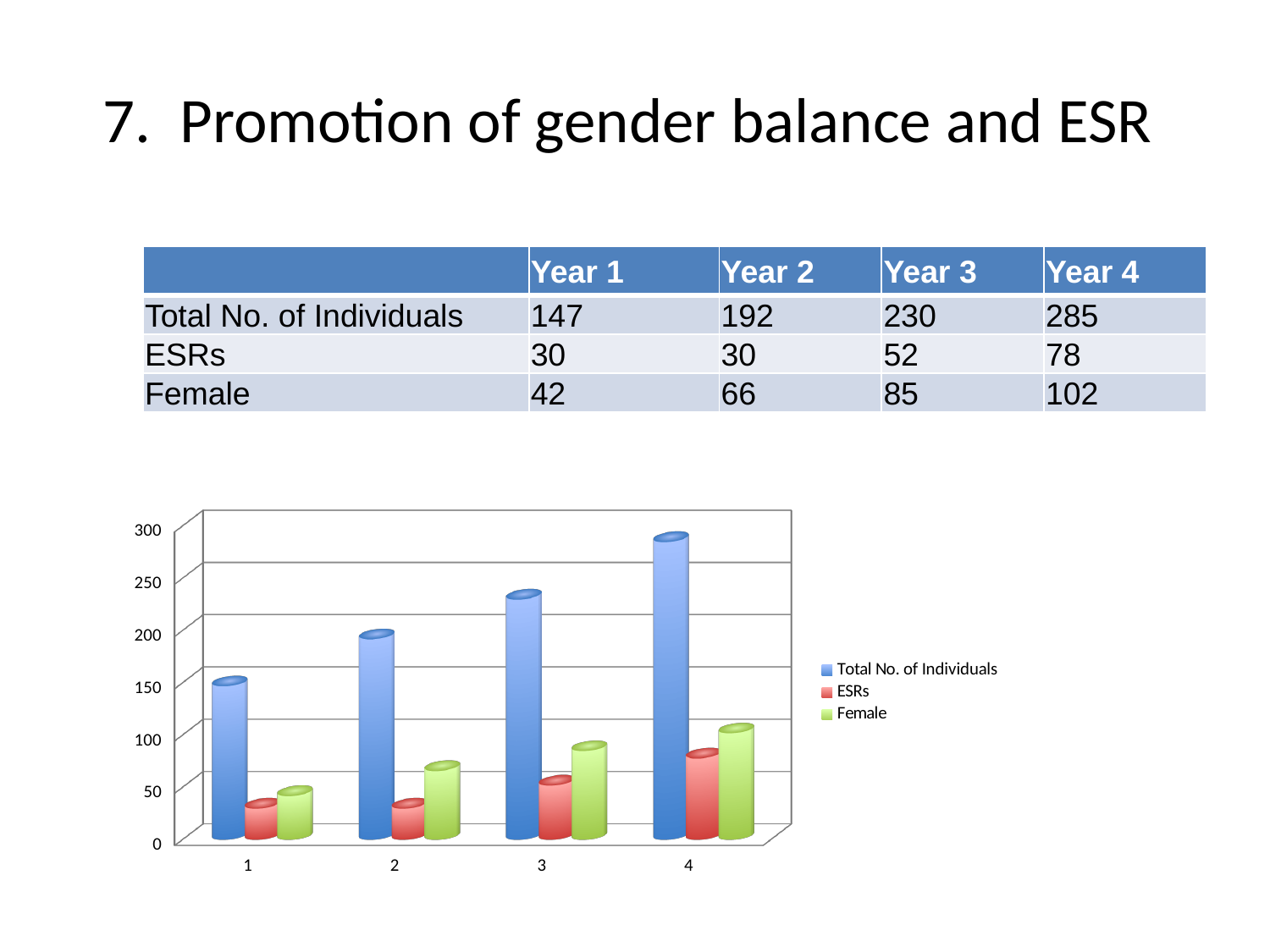
What is the number of ESRs in Year 3? 52 What is the Total No. of Individuals in Year 4? 285 How many series does the chart legend list? 3 In which year is the Total No. of Individuals highest? Year 4 In which year is the Female value lowest? Year 1 What is the difference between the Total No. of Individuals in Year 4 and Year 1? 138 Which is larger in Year 3, ESRs or Female? Female What is the Female value in Year 2? 66 Do the Total No. of Individuals values rise or fall from category 1 to category 4? rise Is the Total No. of Individuals bar for category 2 greater or less than 150? greater How many categories are shown along the x axis of the chart? 4 What kind of chart is shown on the slide? bar chart